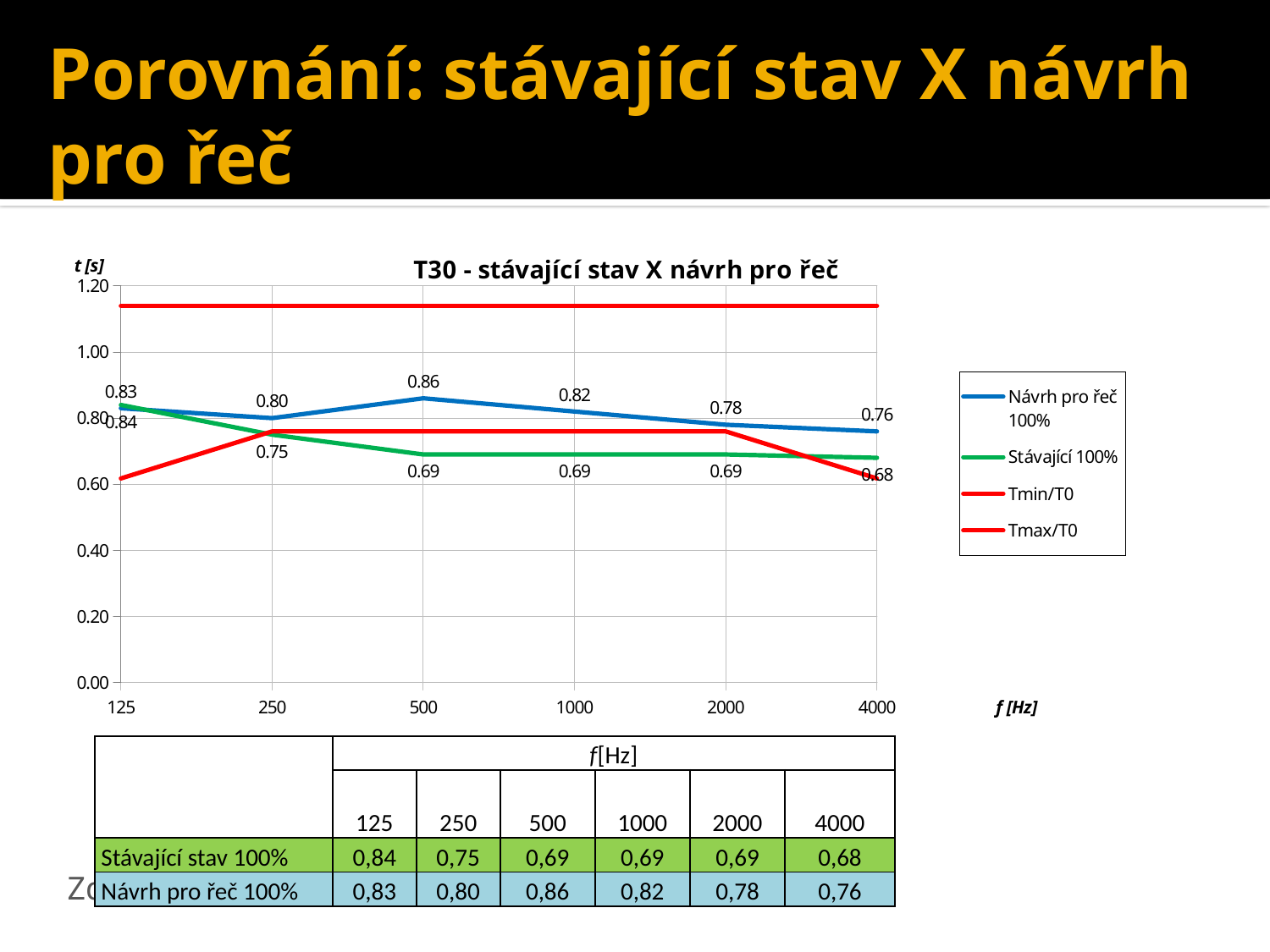
At which frequency does the Stávající 100% series have its lowest value? 4000 Is the Tmax/T0 line greater or less than 1.00? greater How many series does the chart legend list? 4 At which frequency does the Návrh pro řeč 100% series reach its highest value? 500 At 2000 Hz, which series has the larger value: Návrh pro řeč 100% or Stávající 100%? Návrh pro řeč 100% Does the Stávající 100% series rise or fall from 125 Hz to 4000 Hz? fall How many frequency categories are shown on the x axis of the chart? 6 What type of chart is shown on the slide? line chart What is the value of the Návrh pro řeč 100% series at 500 Hz? 0.86 What is the difference between the Návrh pro řeč 100% and Stávající 100% values at 500 Hz? 0.17 What is the title of the chart? T30 - stávající stav X návrh pro řeč What is the value of the Stávající 100% series at 250 Hz? 0.75